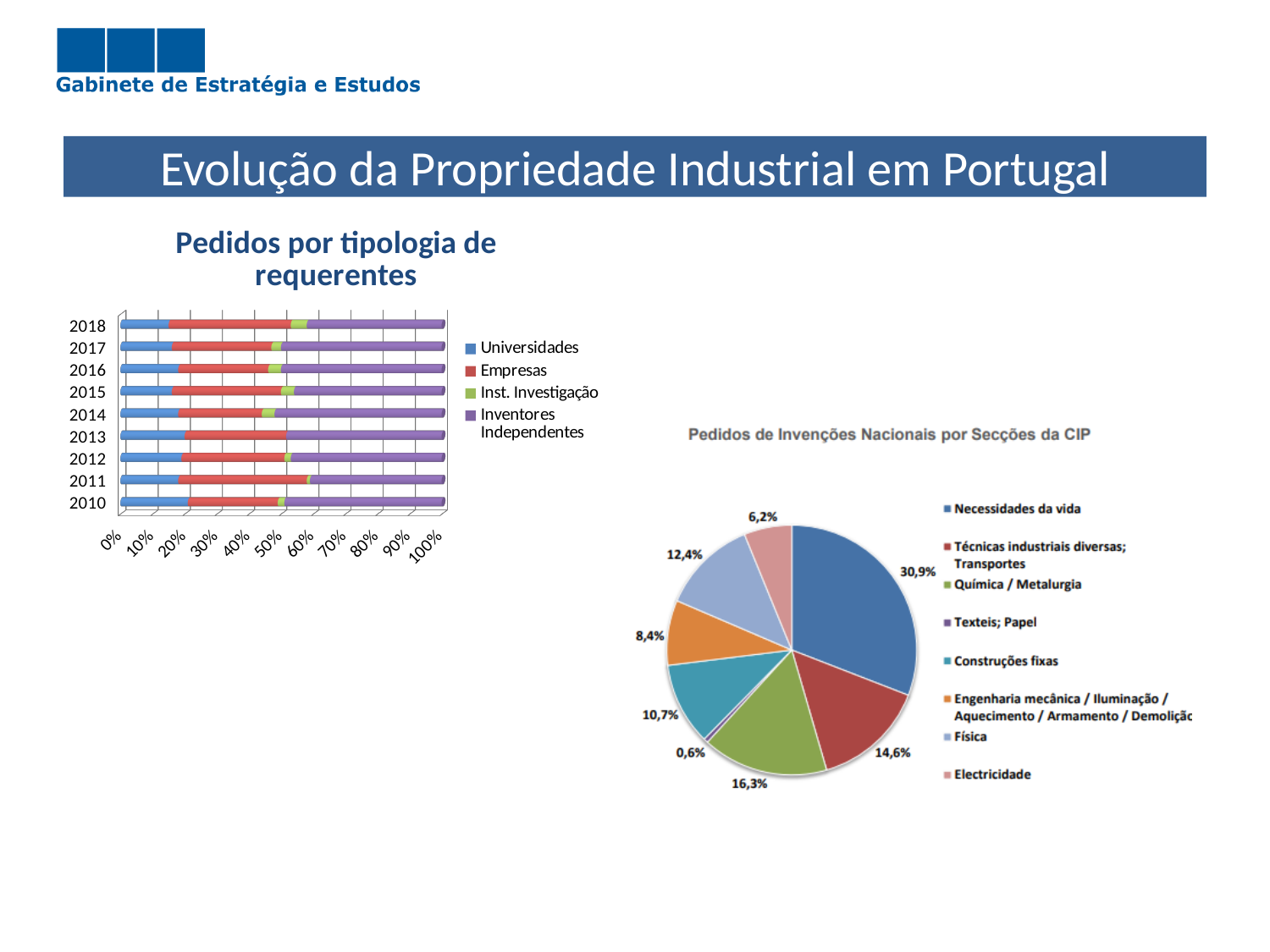
In the 'Pedidos de Invenções Nacionais por Secções da CIP' pie chart, what is the difference between the shares of Física and Electricidade? 6,2% In the 'Pedidos de Invenções Nacionais por Secções da CIP' pie chart, what is the share for Química / Metalurgia? 16,3% In the 'Pedidos de Invenções Nacionais por Secções da CIP' pie chart, which section has the smallest share? Texteis; Papel How many series does the legend of the 'Pedidos por tipologia de requerentes' chart list? 4 In the 'Pedidos por tipologia de requerentes' chart, which series is shown in purple? Inventores Independentes How many slices does the 'Pedidos de Invenções Nacionais por Secções da CIP' pie chart have? 8 How many years are shown on the 'Pedidos por tipologia de requerentes' chart? 9 What type of chart is the 'Pedidos por tipologia de requerentes' chart? bar chart What type of chart is 'Pedidos de Invenções Nacionais por Secções da CIP'? pie chart In the 'Pedidos de Invenções Nacionais por Secções da CIP' pie chart, which section has the largest share? Necessidades da vida In the 'Pedidos por tipologia de requerentes' chart, is the Universidades share for 2018 greater or less than 20%? less In the 'Pedidos de Invenções Nacionais por Secções da CIP' pie chart, what is the share for Necessidades da vida? 30,9%